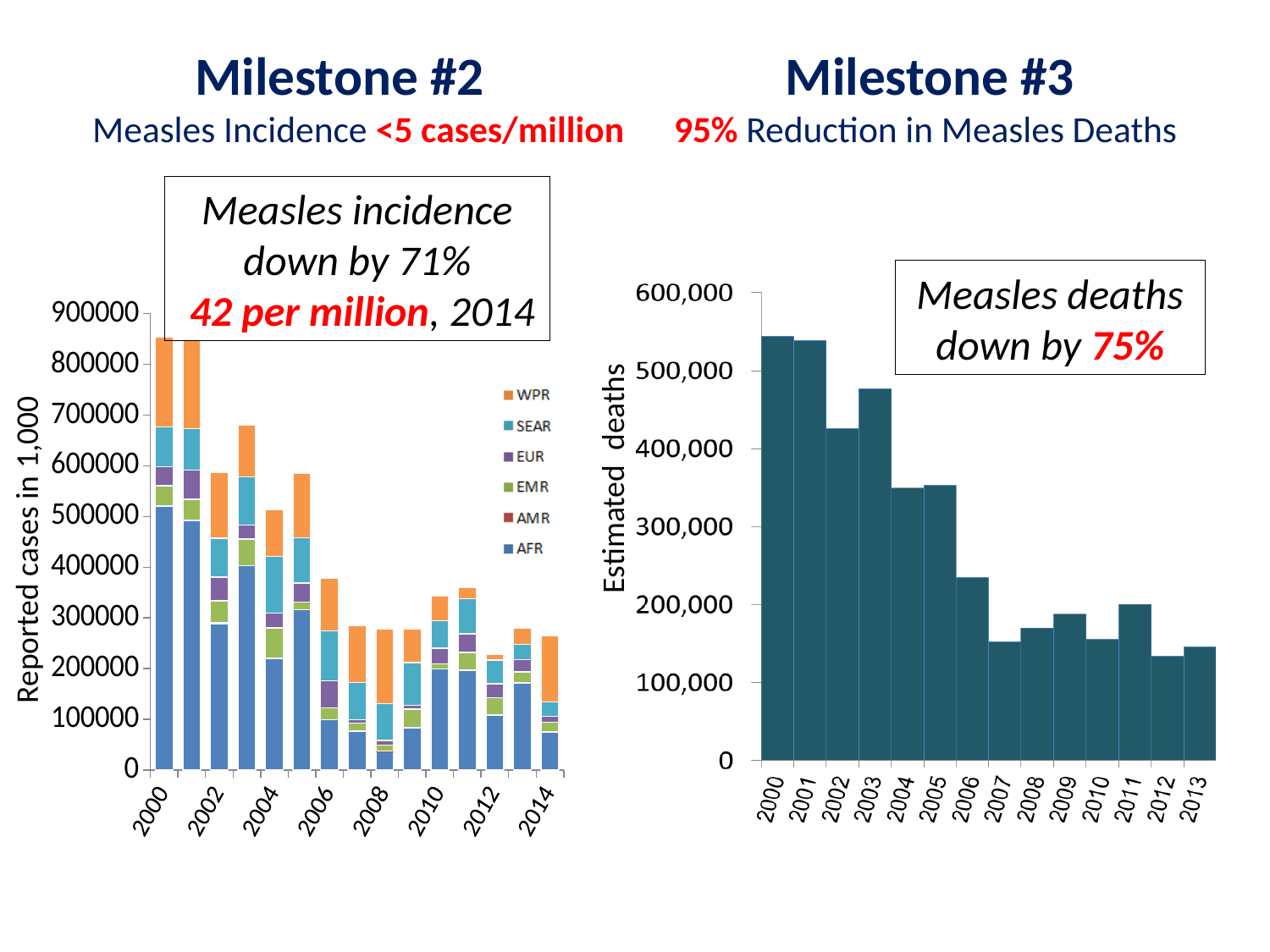
On the left chart (Reported cases in 1,000), is the total for 2000 greater or less than 800000? greater On the left chart (Reported cases in 1,000), how many series does the legend list? 6 On the right chart (Estimated deaths), is the value for 2000 greater or less than 500,000? greater On the right chart (Estimated deaths), do the values generally rise or fall from 2000 to 2013? fall On the left chart (Reported cases in 1,000), how many years (bars) are plotted? 15 On the right chart (Estimated deaths), which is larger, the value for 2002 or the value for 2003? 2003 On the left chart (Reported cases in 1,000), which series is shown in orange at the top of each stacked bar? WPR On the right chart (Estimated deaths), is the value for 2012 greater or less than 200,000? less On the right chart (Estimated deaths), how many years (bars) are plotted? 14 On the left chart (Reported cases in 1,000), what kind of chart is it? stacked bar chart